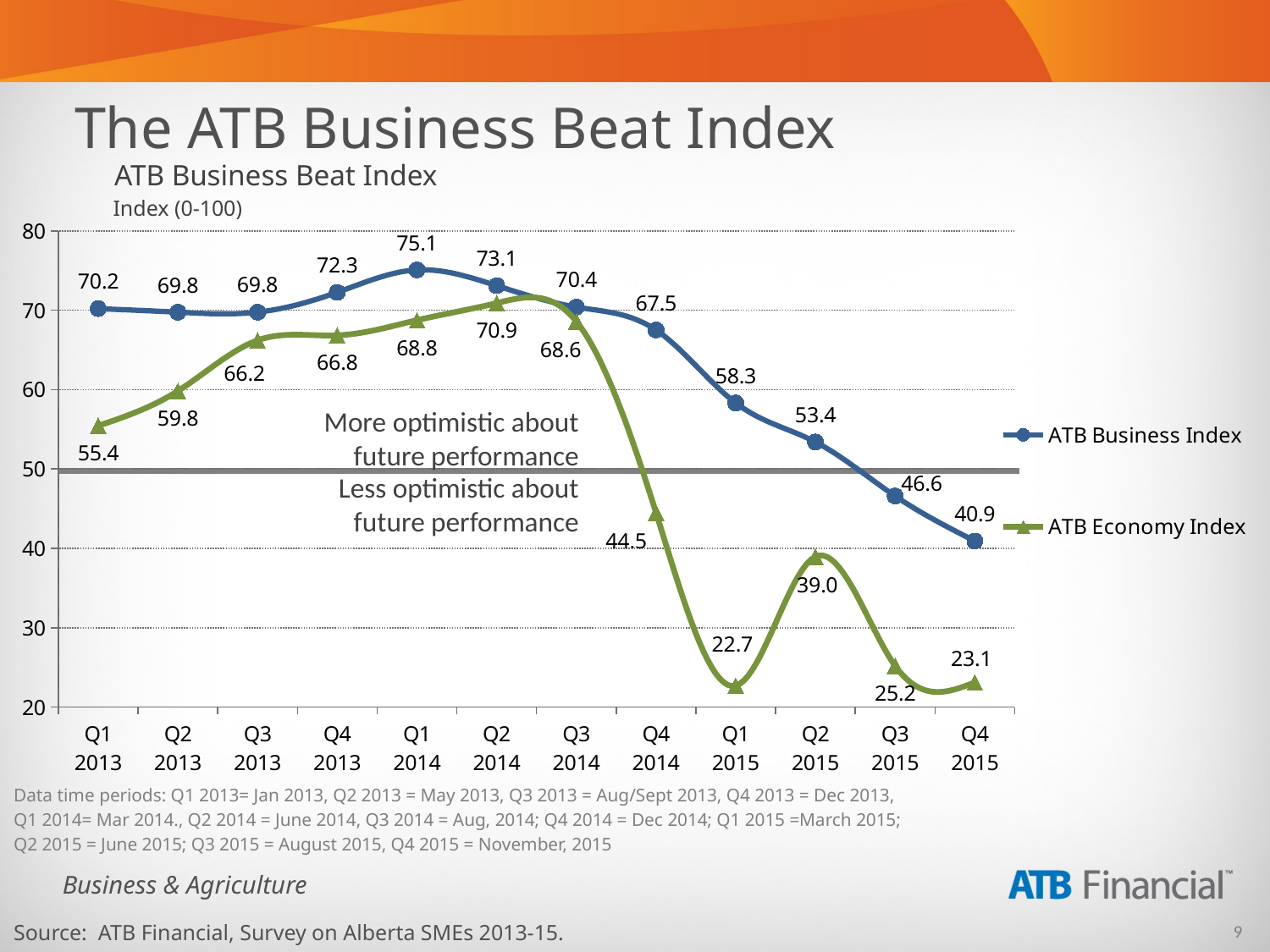
Does the ATB Business Index rise or fall from Q1 2014 to Q4 2015? Fall In which quarter is the ATB Economy Index lowest? Q1 2015 What is the ATB Economy Index value for Q1 2015? 22.7 How many quarters are plotted on the x axis? 12 In which quarter is the ATB Business Index highest? Q1 2014 Which is larger in Q2 2015, the ATB Business Index or the ATB Economy Index? ATB Business Index What is the ATB Economy Index value for Q4 2014? 44.5 How many series does the legend list? 2 What kind of chart is shown on the slide? Line chart What is the ATB Business Index value for Q1 2014? 75.1 What is the difference between the ATB Business Index and the ATB Economy Index in Q4 2015? 17.8 Is the ATB Business Index value for Q3 2015 greater or less than 50? less